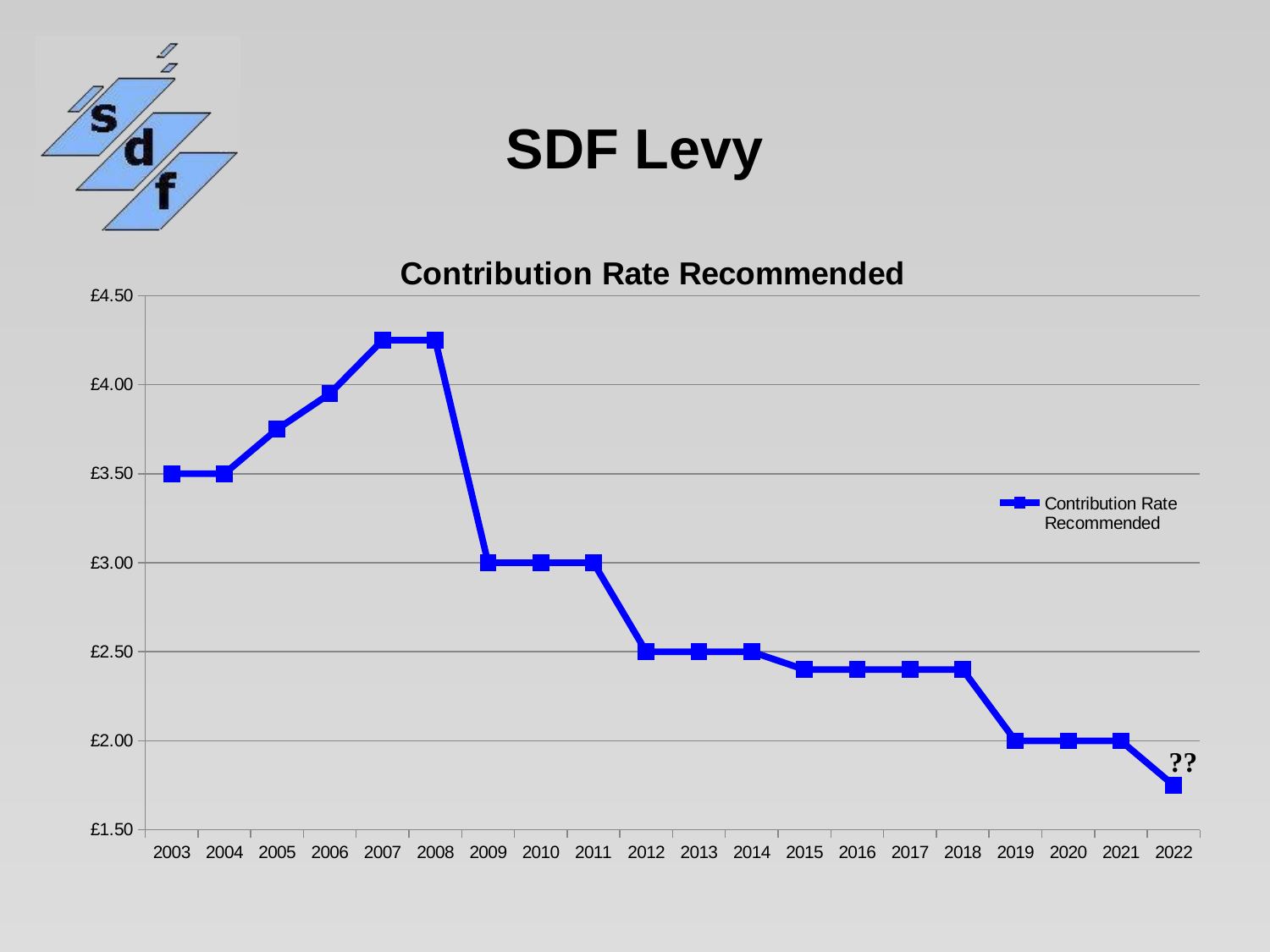
What is the difference between the contribution rate recommended for 2009 and for 2019? £1.00 Is the value for 2007 greater or less than £4.00? greater How many series does the legend list? 1 Which year has the lowest contribution rate recommended? 2022 Overall, do the values rise or fall from 2008 to 2022? fall How many years are plotted along the x axis? 20 What type of chart is shown on the slide? line chart Is the value for 2016 greater or less than £2.50? less What is the contribution rate recommended for 2020? £2.00 What is the contribution rate recommended for 2003? £3.50 What is the chart's title? Contribution Rate Recommended What is the contribution rate recommended for 2010? £3.00